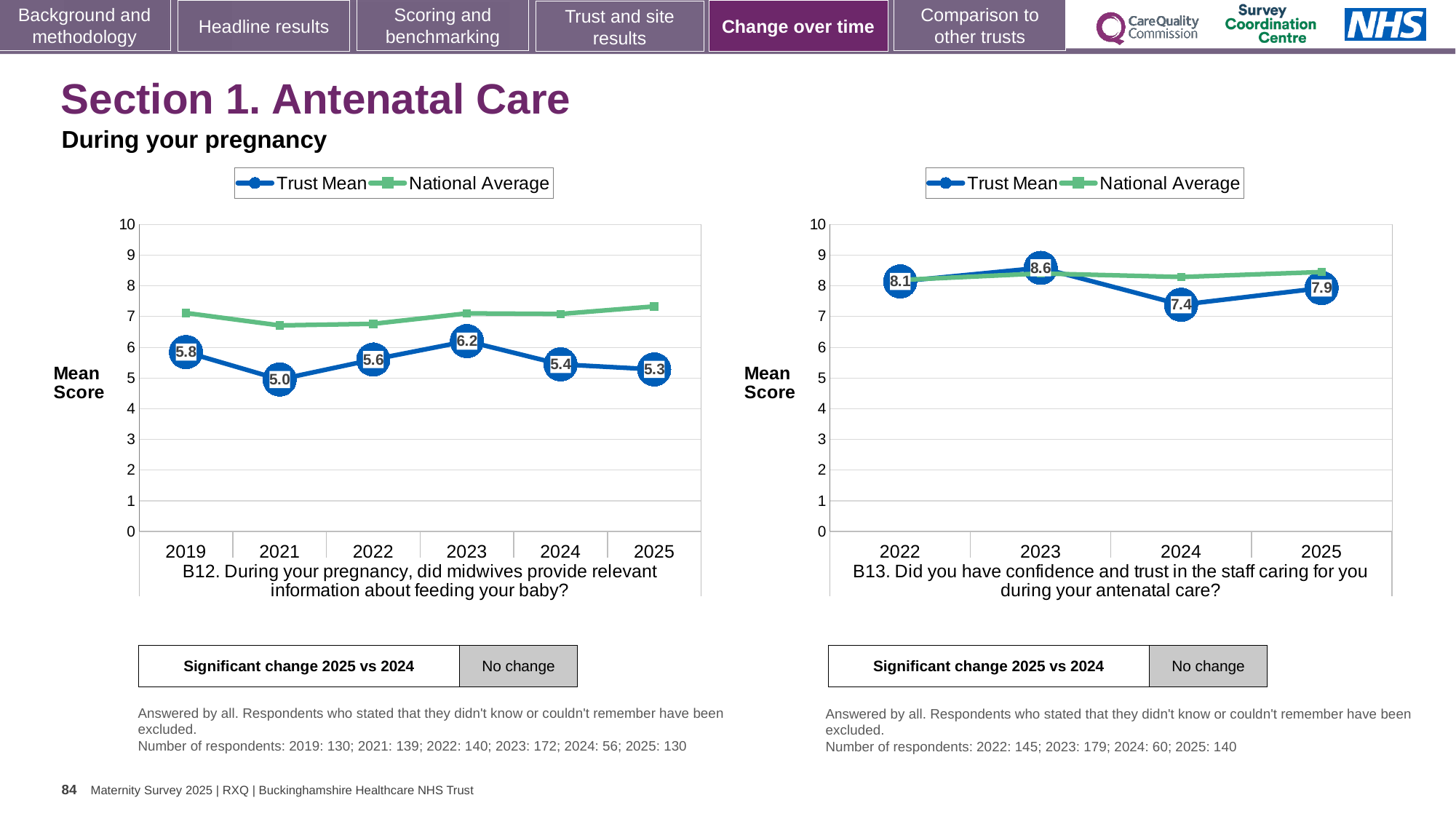
How many series does the legend of the B13 chart (right) list? 2 In the B13 chart (right), what is the Trust Mean for 2024? 7.4 In the B13 chart (right), what is the difference between the Trust Mean for 2023 and 2024? 1.2 In the B12 chart (left), how many years are plotted on the x axis? 6 In the B13 chart (right), which is larger, the Trust Mean for 2022 or for 2025? 2022 What kind of chart is the B12 chart (left)? Line chart In the B13 chart (right), which year has the highest Trust Mean? 2023 In the B12 chart (left), what is the difference between the Trust Mean for 2023 and 2024? 0.8 In the B12 chart (left), what is the Trust Mean for 2021? 5.0 In the B12 chart (left), what is the Trust Mean for 2023? 6.2 In the B12 chart (left), which year has the lowest Trust Mean? 2021 In the B12 chart (left), is the National Average for 2025 greater or less than 7? greater